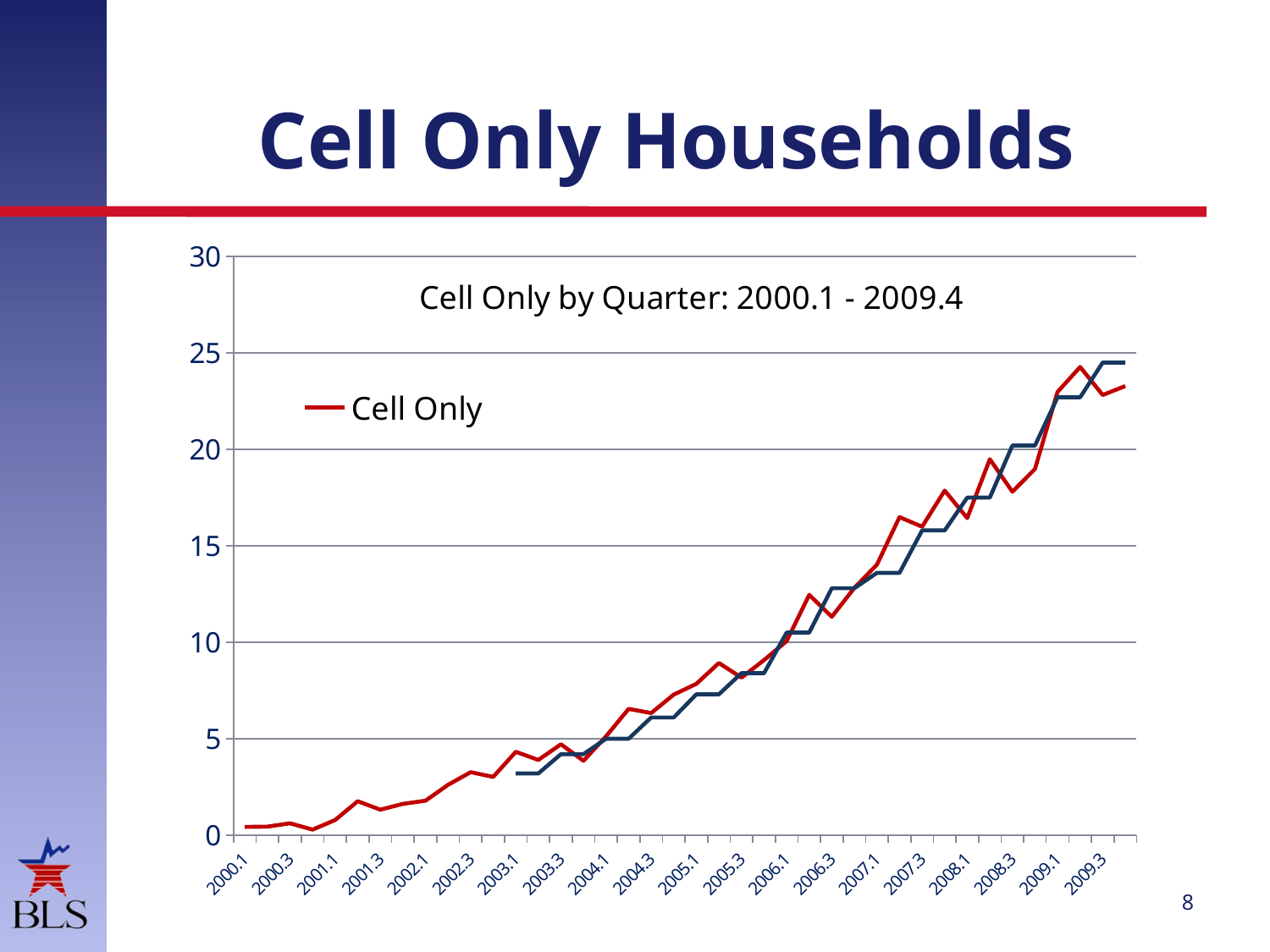
Which is larger, the Cell Only value for 2009.3 or for 2000.1? 2009.3 Do the Cell Only values generally rise or fall from 2000.1 to 2009.4? rise Is the Cell Only value for 2000.1 greater or less than 5? less What kind of chart is shown on the slide? line chart What is the name of the series listed in the legend? Cell Only What is the title of the chart? Cell Only by Quarter: 2000.1 - 2009.4 Is the Cell Only value for 2005.1 greater or less than 10? less Which is larger, the Cell Only value for 2004.1 or for 2008.1? 2008.1 Is the Cell Only value for 2009.3 greater or less than 20? greater How many series does the legend list? 1